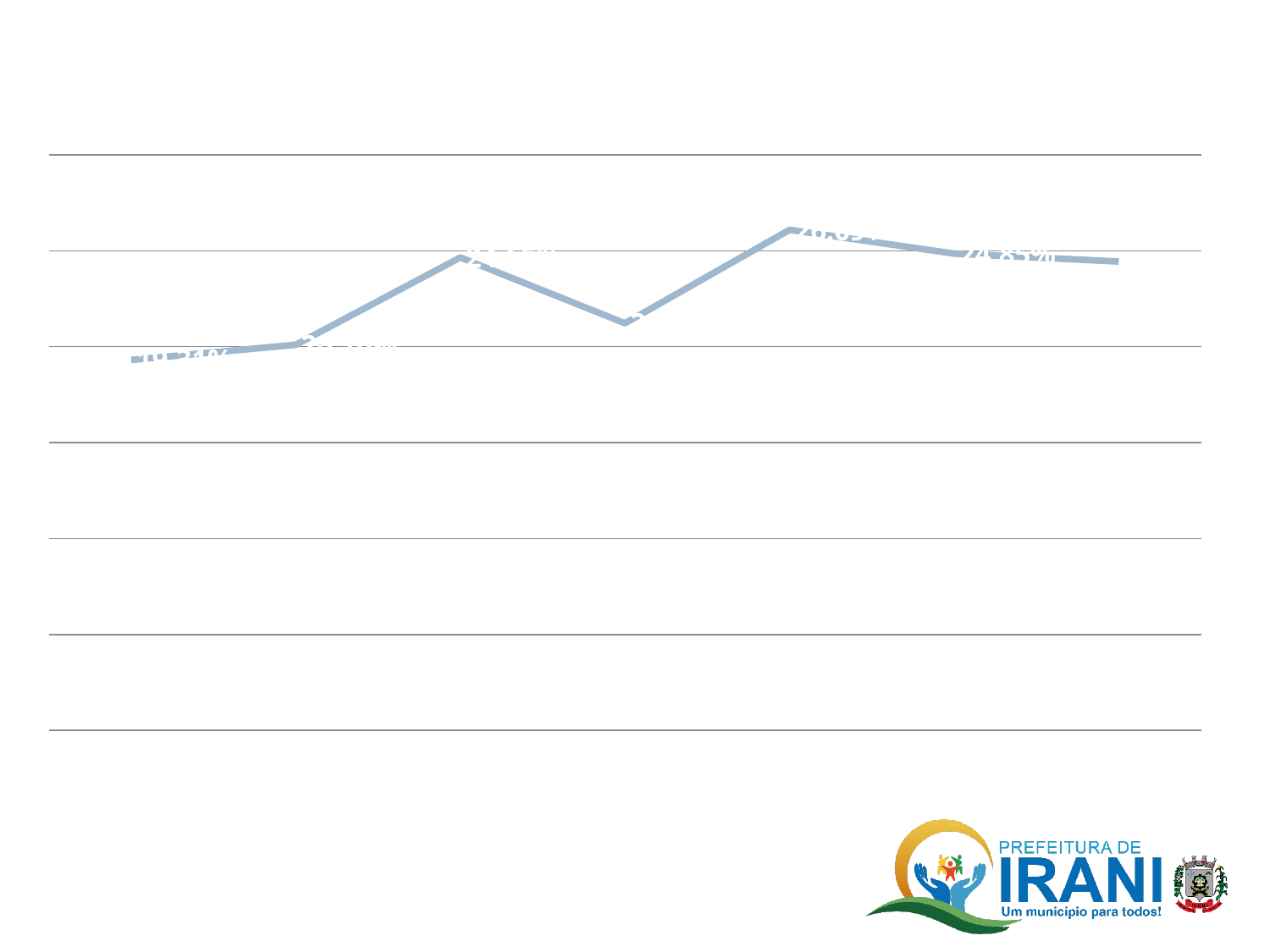
Counting from the left, which data point is the highest on the line? the fifth point Counting from the left, which data point is the lowest on the line? the first point What kind of chart is shown on the slide? line chart Is the third point from the left higher or lower than the second point? higher Is the fifth point from the left higher or lower than the fourth point? higher Does the line rise or fall between the third and fourth points from the left? fall How many lines (series) are plotted on the chart? 1 Does the line rise or fall between the first and second points from the left? rise How many data points are plotted on the line? 7